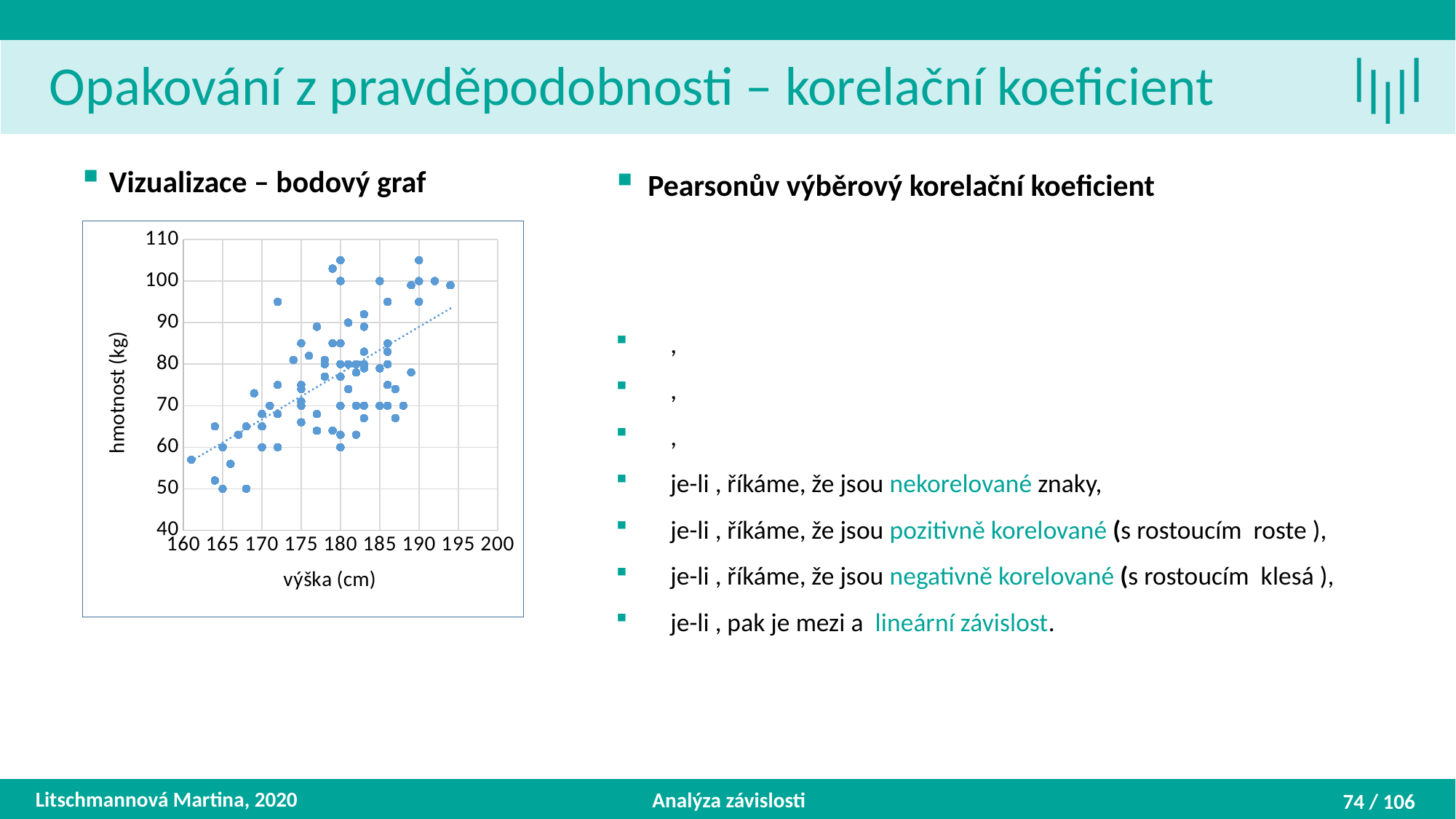
What is the label of the x axis of the chart? výška (cm) Does the dotted trend line in the chart slope upward or downward from left to right? upward What is the label of the y axis of the chart? hmotnost (kg) What kind of chart is shown on the slide? scatter plot As height (výška) increases along the x axis, does weight (hmotnost) generally rise or fall? rise